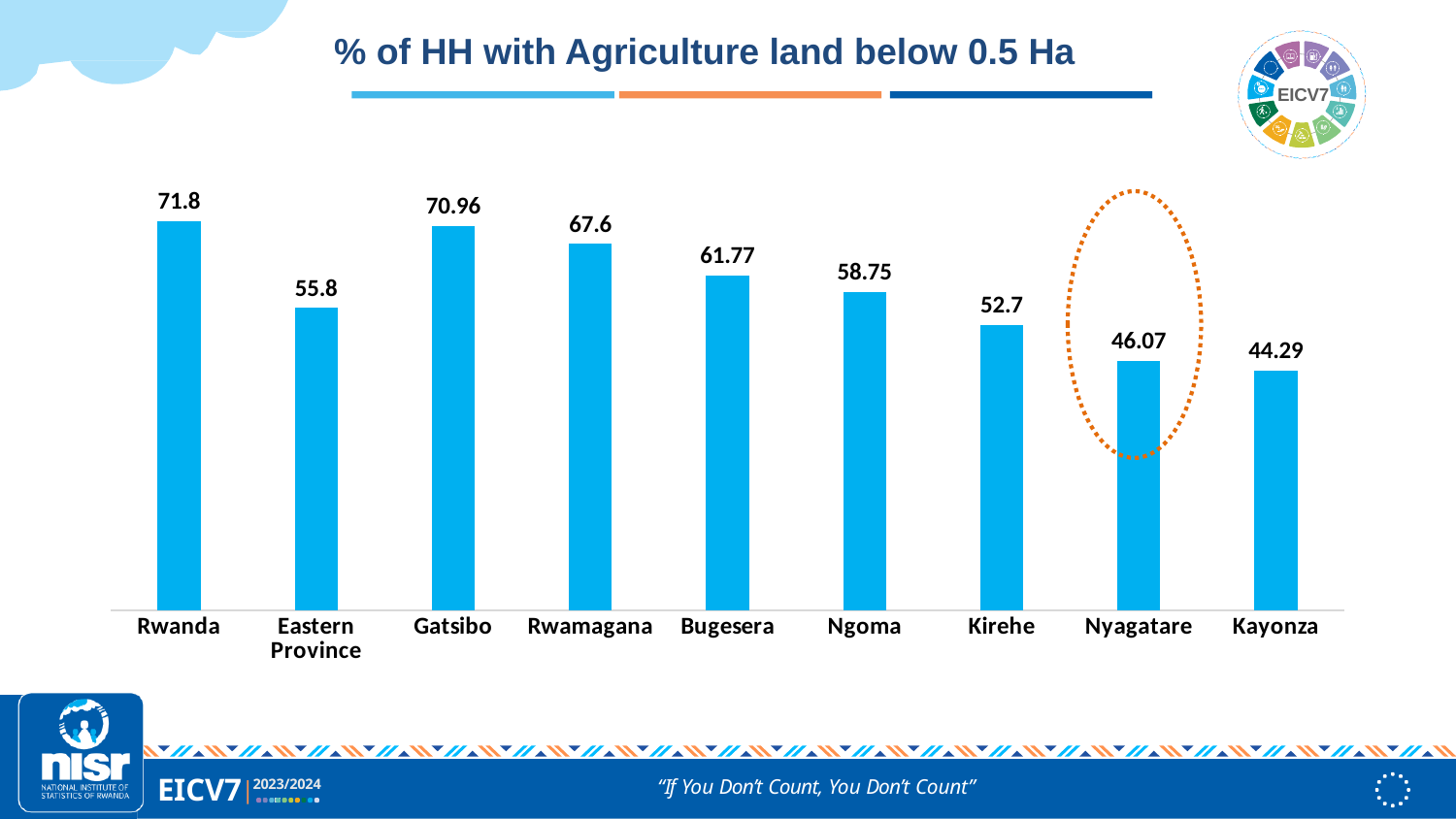
What is the value for Nyagatare? 46.07 What is the value for Eastern Province? 55.8 What is the difference between the values for Rwanda and Eastern Province? 16 Which category has the highest value? Rwanda Which is larger, the value for Rwamagana or the value for Kirehe? Rwamagana What is the title of the chart? % of HH with Agriculture land below 0.5 Ha What kind of chart is this? Bar chart Which category's bar is highlighted with a dotted orange oval? Nyagatare Which category has the lowest value? Kayonza How many categories are shown on the x axis? 9 What is the difference between the values for Bugesera and Ngoma? 3.02 What is the value for Gatsibo? 70.96